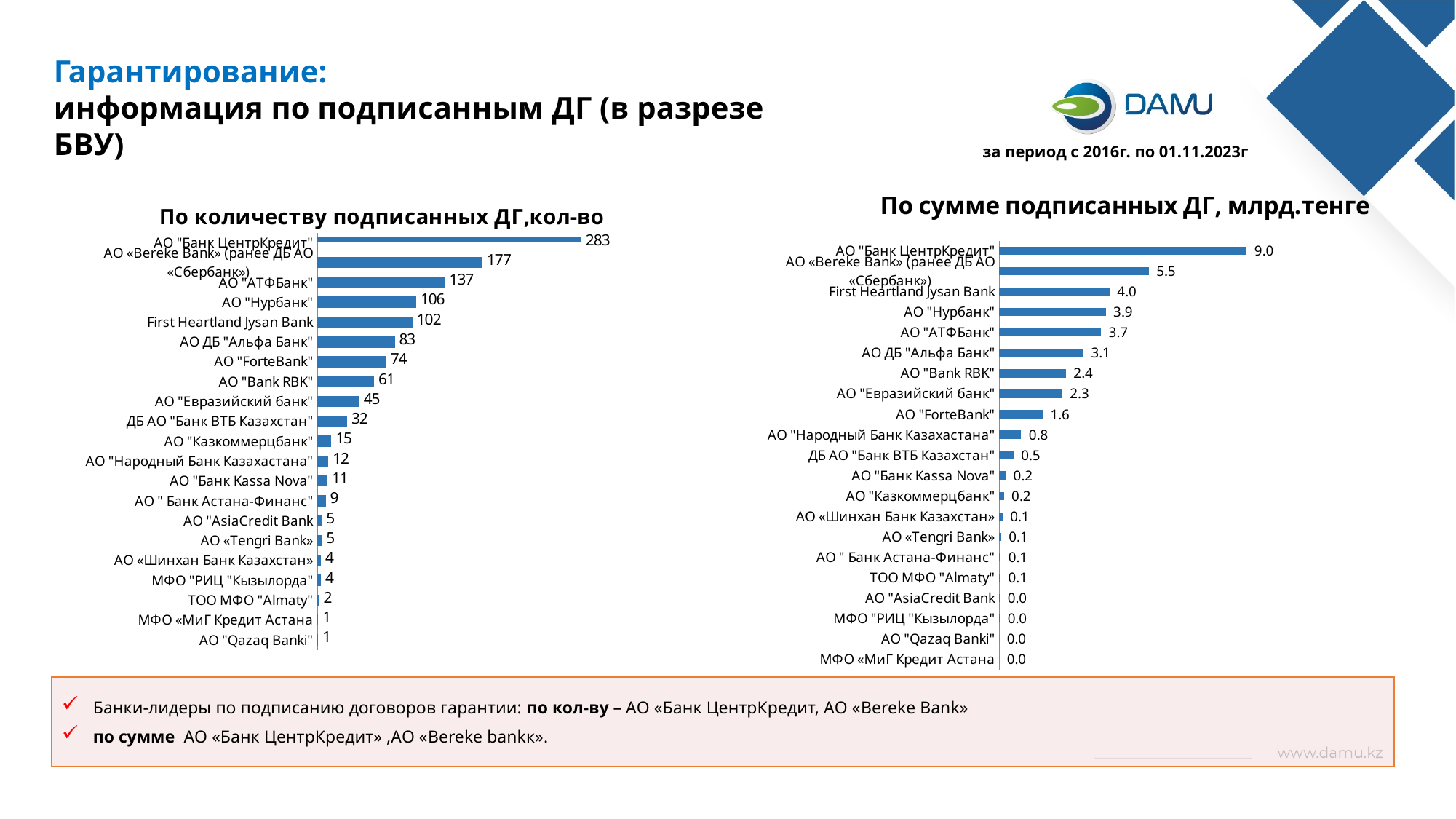
In the chart "По сумме подписанных ДГ, млрд.тенге", what is the value for АО "Народный Банк Казахастана"? 0.8 In the chart "По количеству подписанных ДГ,кол-во", how many banks are listed? 21 What type of chart is "По сумме подписанных ДГ, млрд.тенге"? Bar chart In the chart "По сумме подписанных ДГ, млрд.тенге", what is the difference between АО "Банк ЦентрКредит" and АО «Bereke Bank» (ранее ДБ АО «Сбербанк»)? 3.5 In the chart "По количеству подписанных ДГ,кол-во", what is the value for ДБ АО "Банк ВТБ Казахстан"? 32 In the chart "По сумме подписанных ДГ, млрд.тенге", which is larger: First Heartland Jysan Bank or АО "АТФБанк"? First Heartland Jysan Bank In the chart "По количеству подписанных ДГ,кол-во", which is larger: АО "ForteBank" or АО "Bank RBK"? АО "ForteBank" In the chart "По сумме подписанных ДГ, млрд.тенге", what is the value for АО "Bank RBK"? 2.4 In the chart "По количеству подписанных ДГ,кол-во", which bank has the highest value? АО "Банк ЦентрКредит" In the chart "По сумме подписанных ДГ, млрд.тенге", what is the value for АО "Нурбанк"? 3.9 In the chart "По количеству подписанных ДГ,кол-во", what is the value for АО "АТФБанк"? 137 In the chart "По количеству подписанных ДГ,кол-во", what is the difference between АО "Банк ЦентрКредит" and АО «Bereke Bank» (ранее ДБ АО «Сбербанк»)? 106